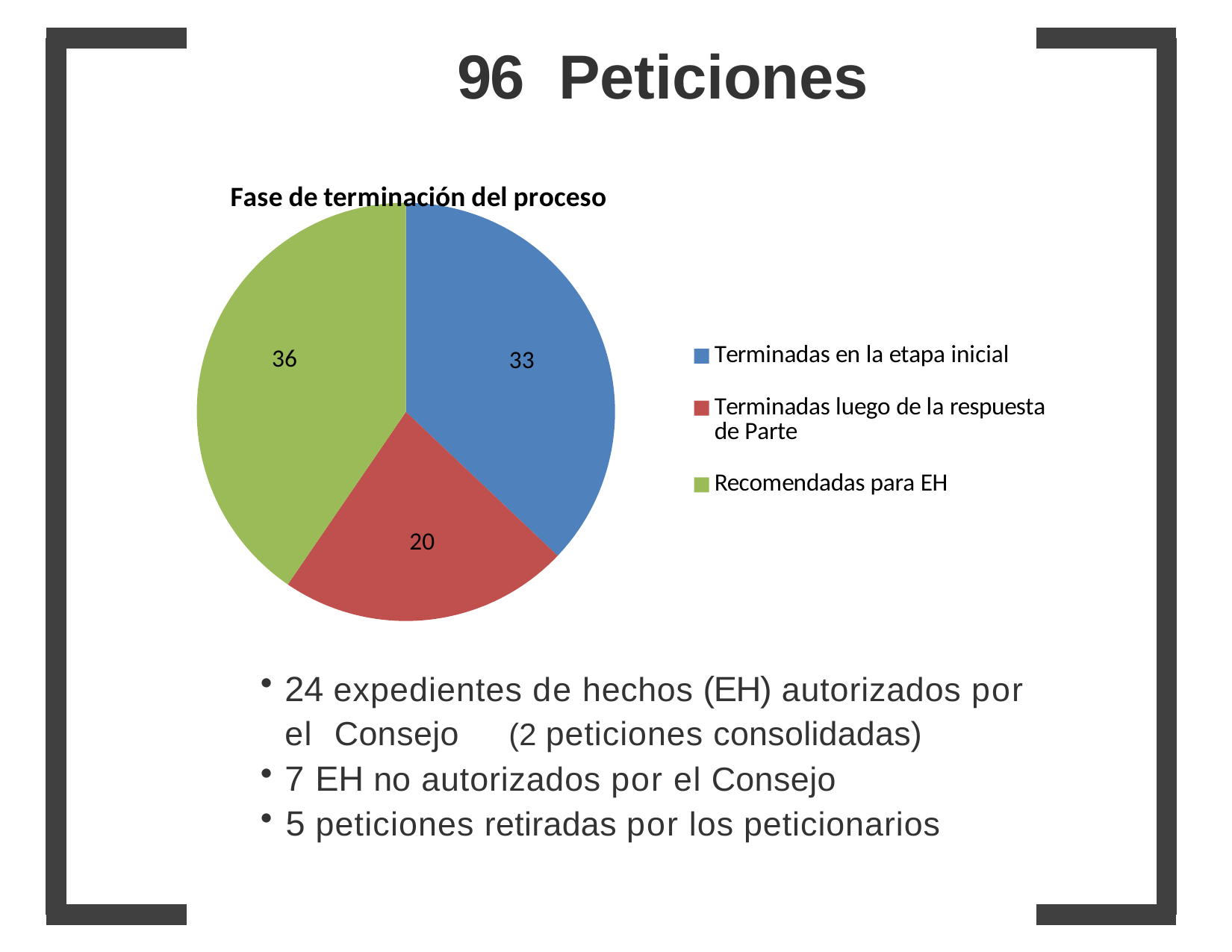
Which category has the smallest slice of the pie? Terminadas luego de la respuesta de Parte What is the title of the chart? Fase de terminación del proceso How many categories does the pie chart have? 3 What is the value for "Recomendadas para EH"? 36 What is the difference between the values for "Terminadas en la etapa inicial" and "Terminadas luego de la respuesta de Parte"? 13 Which category has the largest slice of the pie? Recomendadas para EH What type of chart is shown on the slide? Pie chart What is the difference between the values for "Recomendadas para EH" and "Terminadas en la etapa inicial"? 3 Which is larger: "Terminadas en la etapa inicial" or "Terminadas luego de la respuesta de Parte"? Terminadas en la etapa inicial What colour is the slice for "Recomendadas para EH"? Green What is the value for "Terminadas en la etapa inicial"? 33 What is the value for "Terminadas luego de la respuesta de Parte"? 20